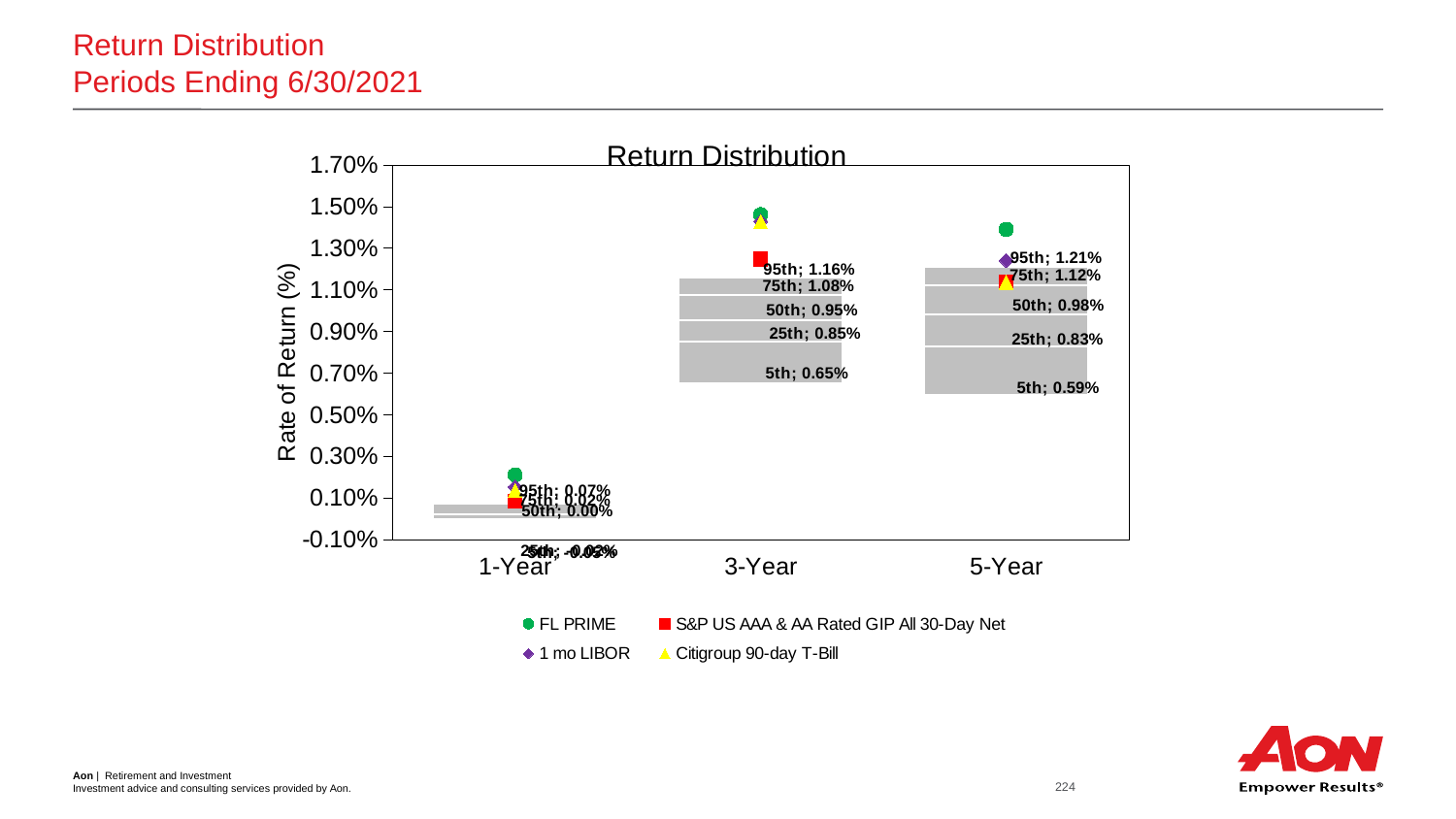
What is the 5th percentile value shown for the 5-Year period? 0.59% What is the difference between the 95th and 5th percentile values for the 3-Year period? 0.51% Is the FL PRIME value for the 1-Year period greater or less than 0.30%? less What is the 50th percentile value shown for the 3-Year period? 0.95% Is the FL PRIME value for the 3-Year period greater or less than 1.30%? greater What is the 95th percentile value shown for the 5-Year period? 1.21% Which period has the higher 5th percentile value, 3-Year or 5-Year? 3-Year How many series does the chart legend list? 4 What is the difference between the 95th and 75th percentile values for the 5-Year period? 0.09% How many periods are shown on the x axis of the chart? 3 Which period has the higher 50th percentile value, 3-Year or 5-Year? 5-Year What is the 25th percentile value shown for the 3-Year period? 0.85%